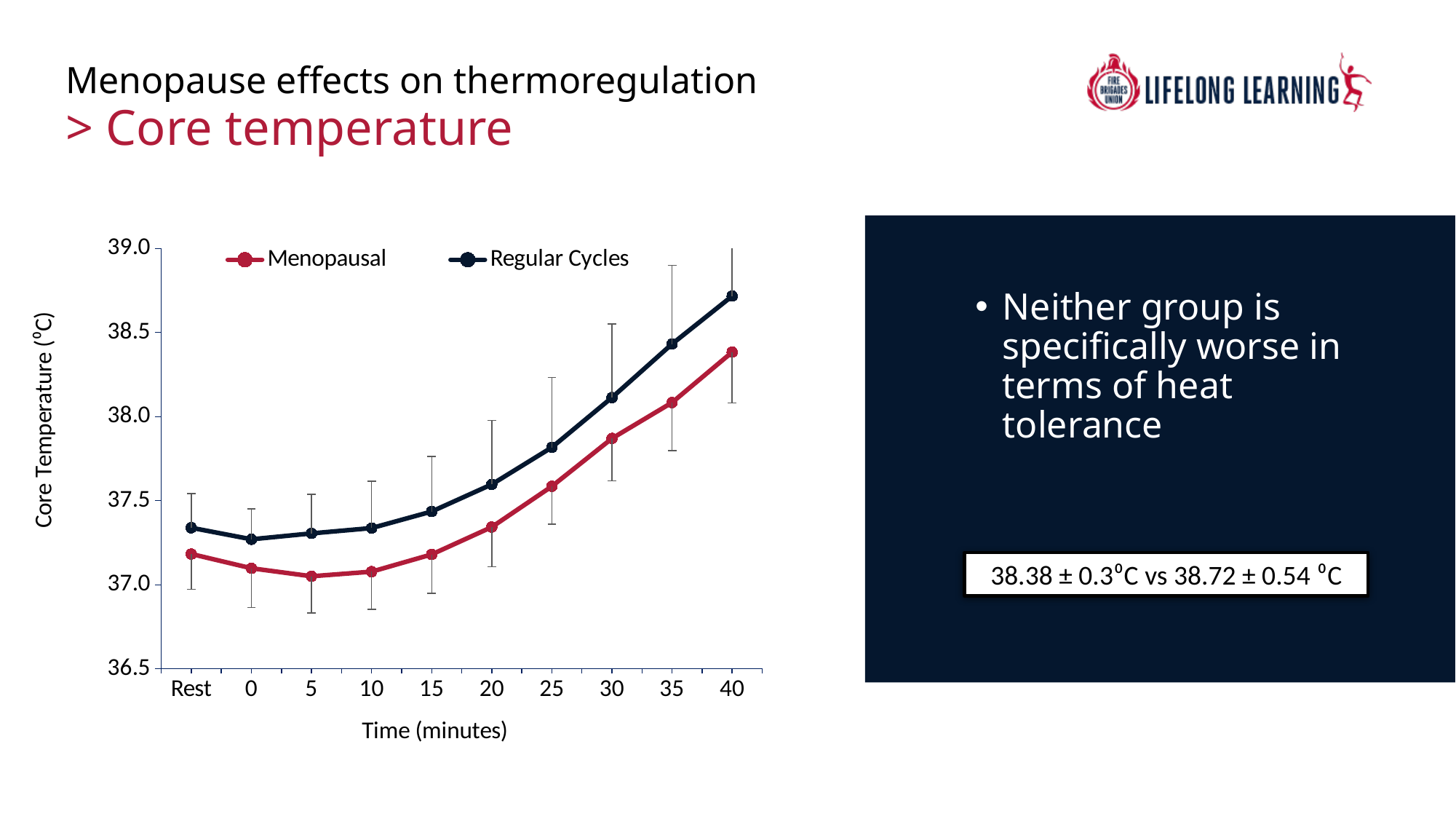
Which series has the higher core temperature at 40 minutes? Regular Cycles Is the Menopausal value at 5 minutes greater or less than 37.5? less What kind of chart is shown on the slide? Line chart How many time points are plotted along the x axis of the chart? 10 At which time point does the Menopausal series reach its highest value? 40 What is the label on the x axis of the chart? Time (minutes) Do the core temperature values for both series rise or fall between 10 and 40 minutes? Rise Which series has the higher core temperature at Rest? Regular Cycles How many series does the chart legend list? 2 Is the Regular Cycles value at 40 minutes greater or less than 38.5? greater Is the Menopausal value at 40 minutes greater or less than 38.0? greater At which time point does the Regular Cycles series reach its highest value? 40